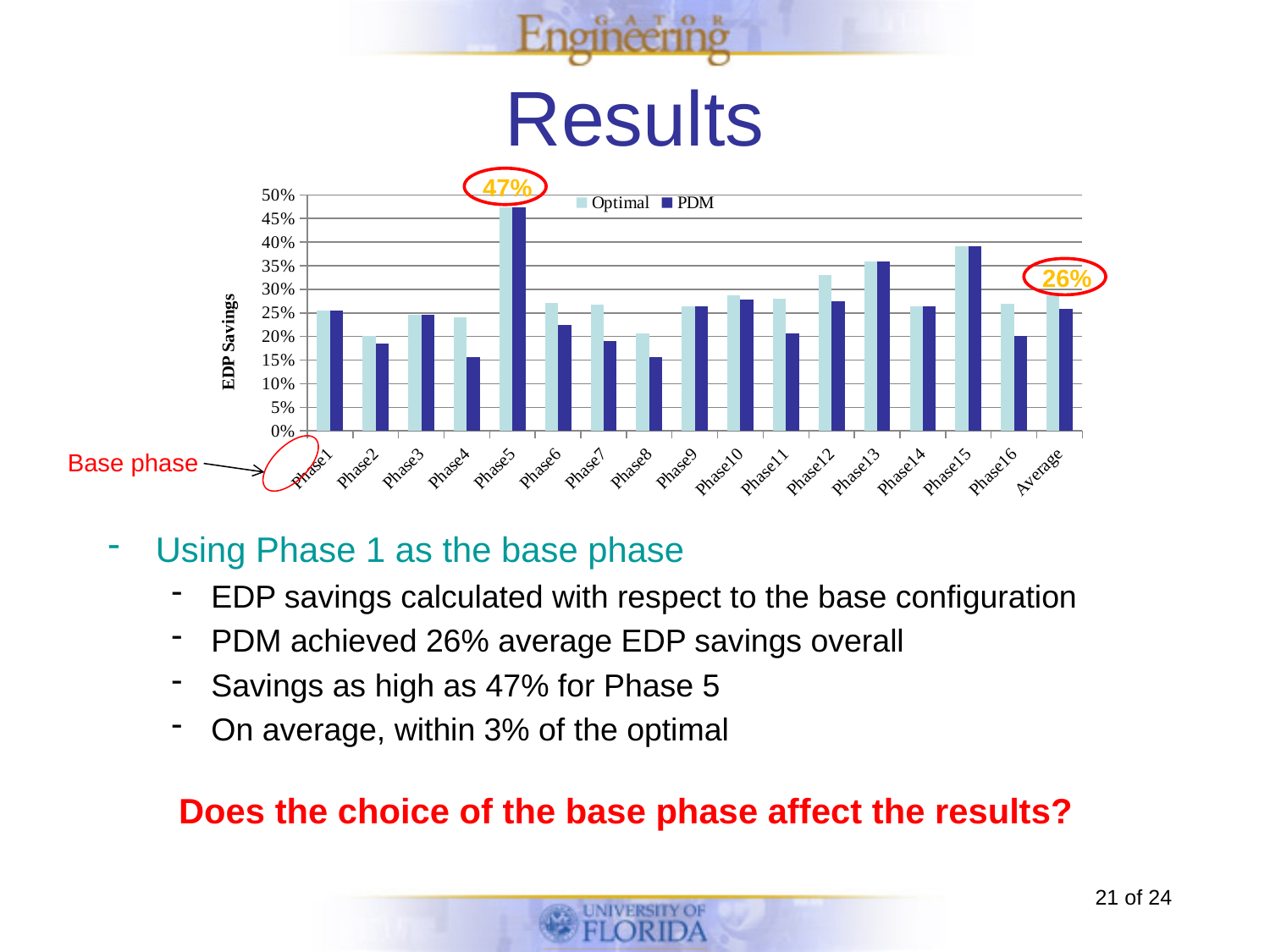
What is the PDM EDP savings value for Phase5, as annotated on the chart? 47% Which has the larger PDM value, Phase5 or Phase15? Phase5 What is the PDM EDP savings value for Average, as annotated on the chart? 26% Which phase has the highest PDM EDP savings? Phase5 How many categories are shown along the x axis of the chart? 17 Is the PDM value for Phase4 greater or less than 20%? less What are the two series named in the legend? Optimal and PDM Which is larger for Phase11, the Optimal value or the PDM value? Optimal How many series does the legend list? 2 What is the label on the vertical axis of the chart? EDP Savings Is the Optimal value for Phase15 greater or less than 35%? greater What kind of chart is shown on the slide? bar chart